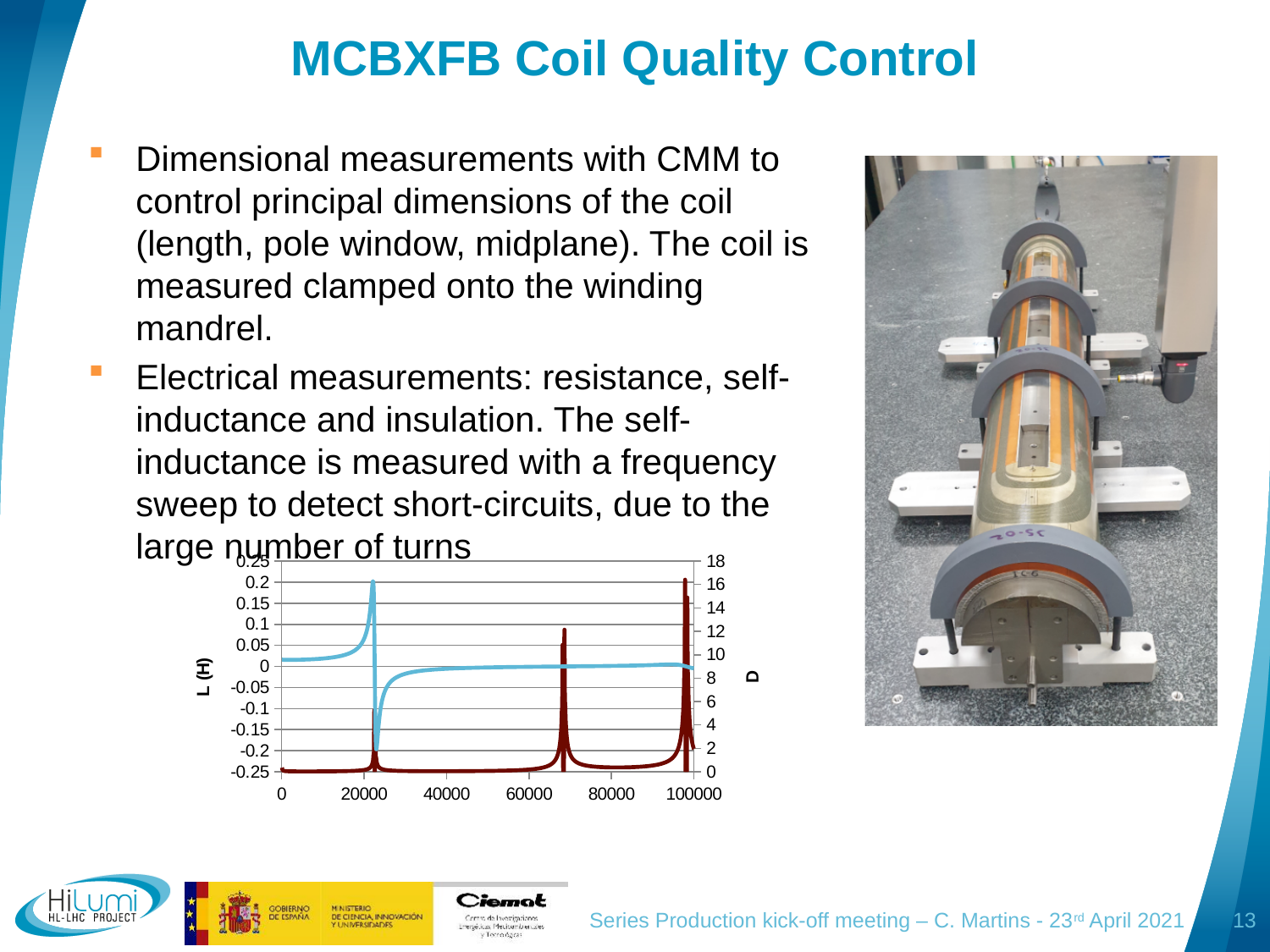
What is the label of the left vertical axis of the chart? L (H) Is the peak of the dark red line near 68000 on the x axis greater or less than 10 on the right axis? greater How many lines are plotted on the chart? 2 Is the peak of the light blue line near 22000 on the x axis greater or less than 0.15 on the left axis? greater What is the largest value shown on the horizontal axis of the chart? 100000 What is the maximum value shown on the right vertical axis of the chart? 18 What kind of chart is shown on the slide? line chart What is the minimum value shown on the left vertical axis of the chart? -0.25 Does the light blue line rise or fall between 0 and about 20000 on the x axis? rise How many sharp peaks does the dark red line show across the chart? 3 What is the label of the right vertical axis of the chart? D Is the highest peak of the dark red line (near 100000 on the x axis) greater or less than 14 on the right axis? greater